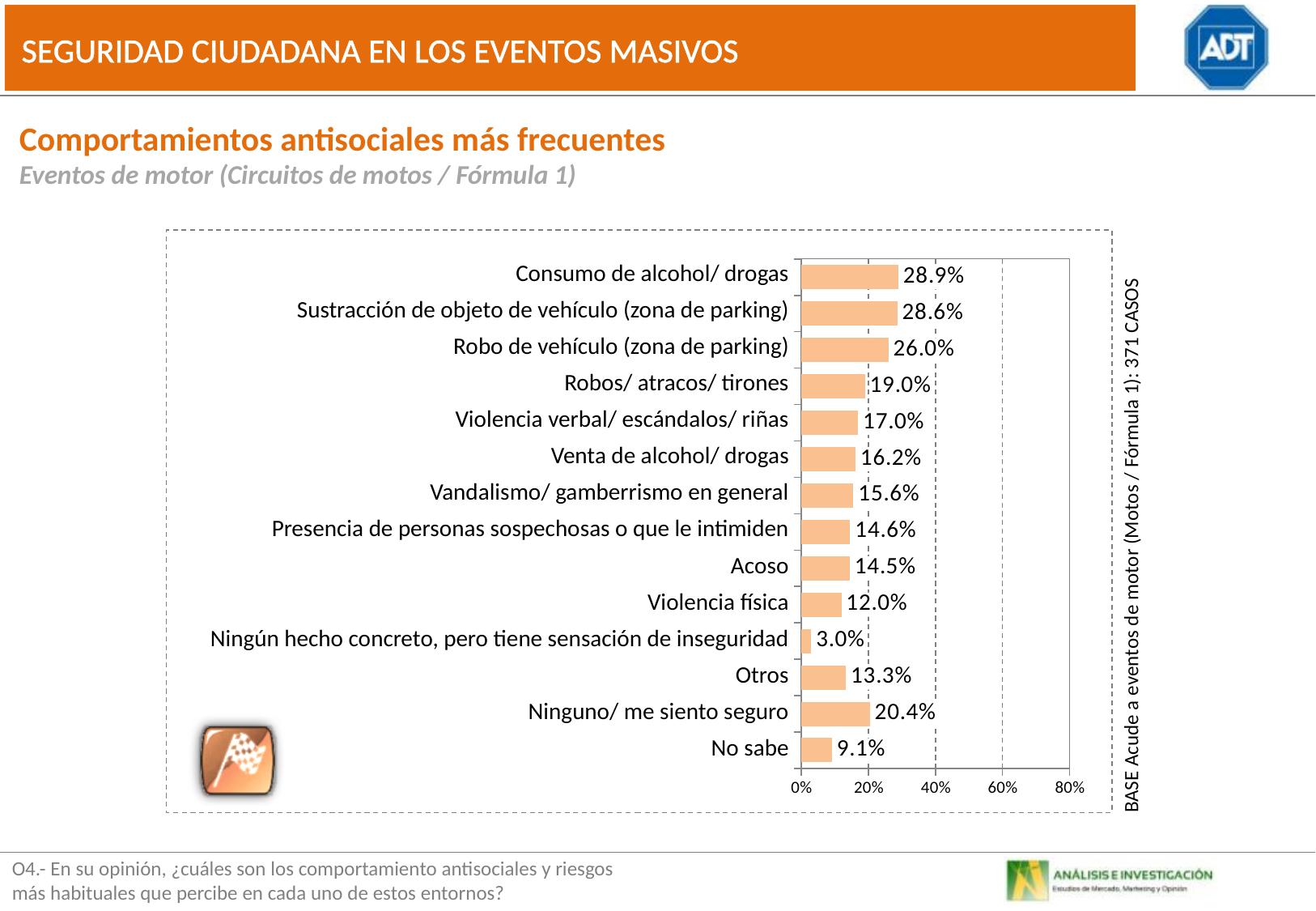
Is the value for "Otros" greater or less than 20%? less What is the value for "Ninguno/ me siento seguro"? 20.4% What is the base (number of cases) stated next to the chart? 371 CASOS What kind of chart is shown on the slide? bar chart What is the difference between "Robos/ atracos/ tirones" and "Violencia física"? 7.0% How many categories are shown in the chart? 14 What is the value for "Robo de vehículo (zona de parking)"? 26.0% Which category has the lowest value? Ningún hecho concreto, pero tiene sensación de inseguridad Which category has the highest value? Consumo de alcohol/ drogas Which is larger, "Venta de alcohol/ drogas" or "Vandalismo/ gamberrismo en general"? Venta de alcohol/ drogas What is the value for "No sabe"? 9.1% What is the value for "Consumo de alcohol/ drogas"? 28.9%